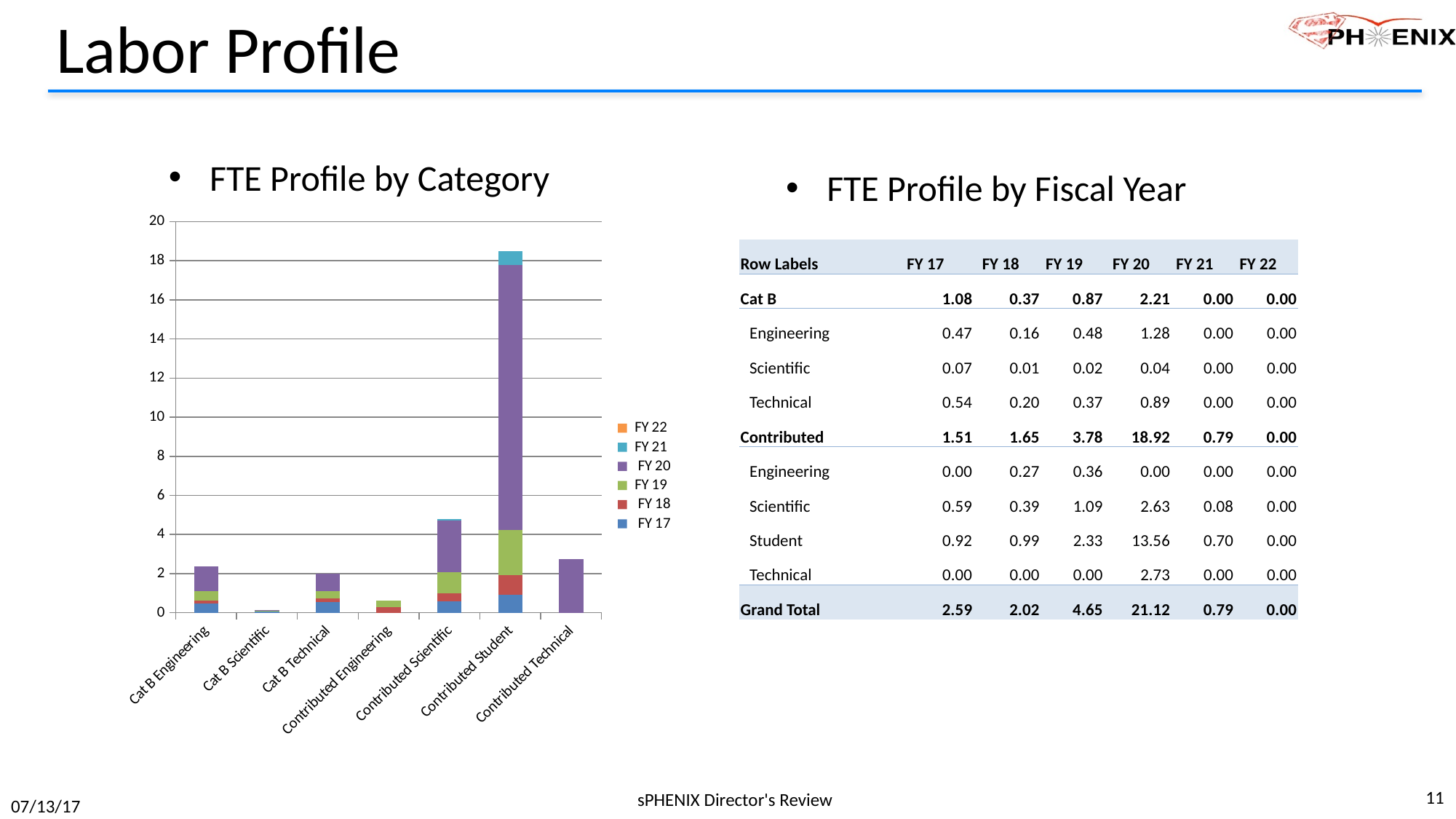
What is the highest value shown on the y axis of the FTE Profile by Category chart? 20 Which category has the shortest bar in the FTE Profile by Category chart? Cat B Scientific In the FTE Profile by Category chart, is the total bar for Contributed Scientific greater or less than 6? less In the FTE Profile by Category chart, which bar is taller: Contributed Scientific or Contributed Technical? Contributed Scientific Which category has the tallest bar in the FTE Profile by Category chart? Contributed Student In the FTE Profile by Category chart, which bar is taller: Cat B Technical or Contributed Engineering? Cat B Technical Which fiscal year series makes up the largest segment of the Contributed Student bar in the FTE Profile by Category chart? FY 20 How many categories are shown on the x axis of the FTE Profile by Category chart? 7 In the FTE Profile by Category chart, is the total bar for Contributed Student greater or less than 16? greater What kind of chart is shown under "FTE Profile by Category"? Stacked bar chart How many series does the legend of the FTE Profile by Category chart list? 6 In the FTE Profile by Category chart, is the total bar for Contributed Technical greater or less than 4? less